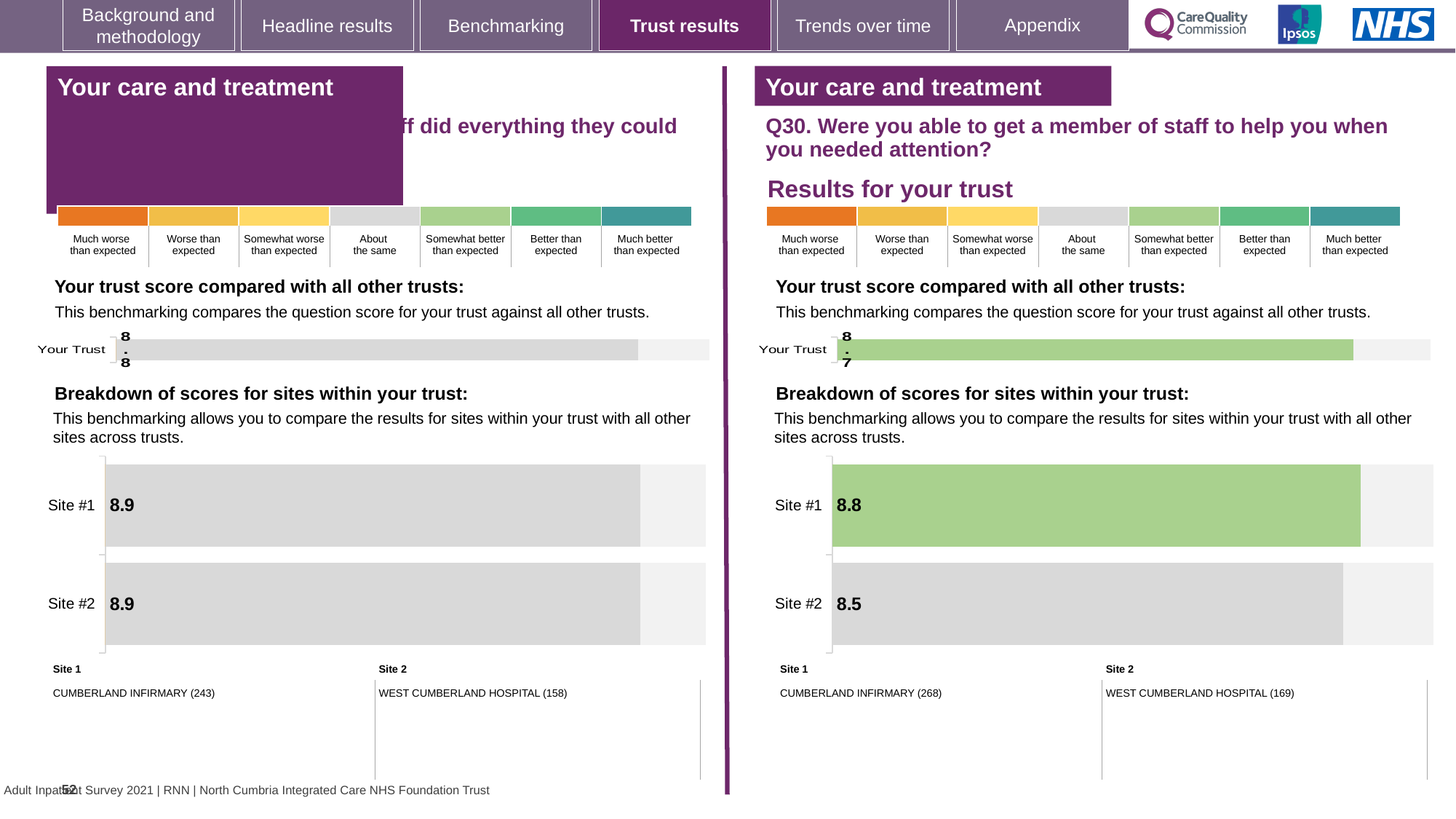
On the right-hand side (Q30), what is the score for Site #2 in the breakdown of scores for sites within your trust? 8.5 On the left-hand side of the slide, what is the score for Site #2 in the breakdown of scores for sites within your trust? 8.9 On the right-hand side (Q30), what is the difference between the Site #1 and Site #2 scores? 0.3 On the right-hand side (Q30), is the Site #1 score larger or smaller than the Site #2 score? larger On the left-hand side of the slide, what is the score for Site #1 in the breakdown of scores for sites within your trust? 8.9 On the right-hand side (Q30), what is the score for Site #1 in the breakdown of scores for sites within your trust? 8.8 How many sites are shown in the breakdown of scores chart on the right-hand side (Q30)? 2 On the right-hand side (Q30), what colour is the Site #1 bar in the breakdown of scores chart? green What type of chart is used for the breakdown of scores for sites within your trust on the right-hand side (Q30)? bar chart On the right-hand side (Q30), what is the 'Your Trust' score shown in the trust score comparison chart? 8.7 On the left-hand side of the slide, what is the 'Your Trust' score shown in the trust score comparison chart? 8.8 On the right-hand side (Q30), which site has the higher score in the breakdown of scores for sites within your trust? Site #1